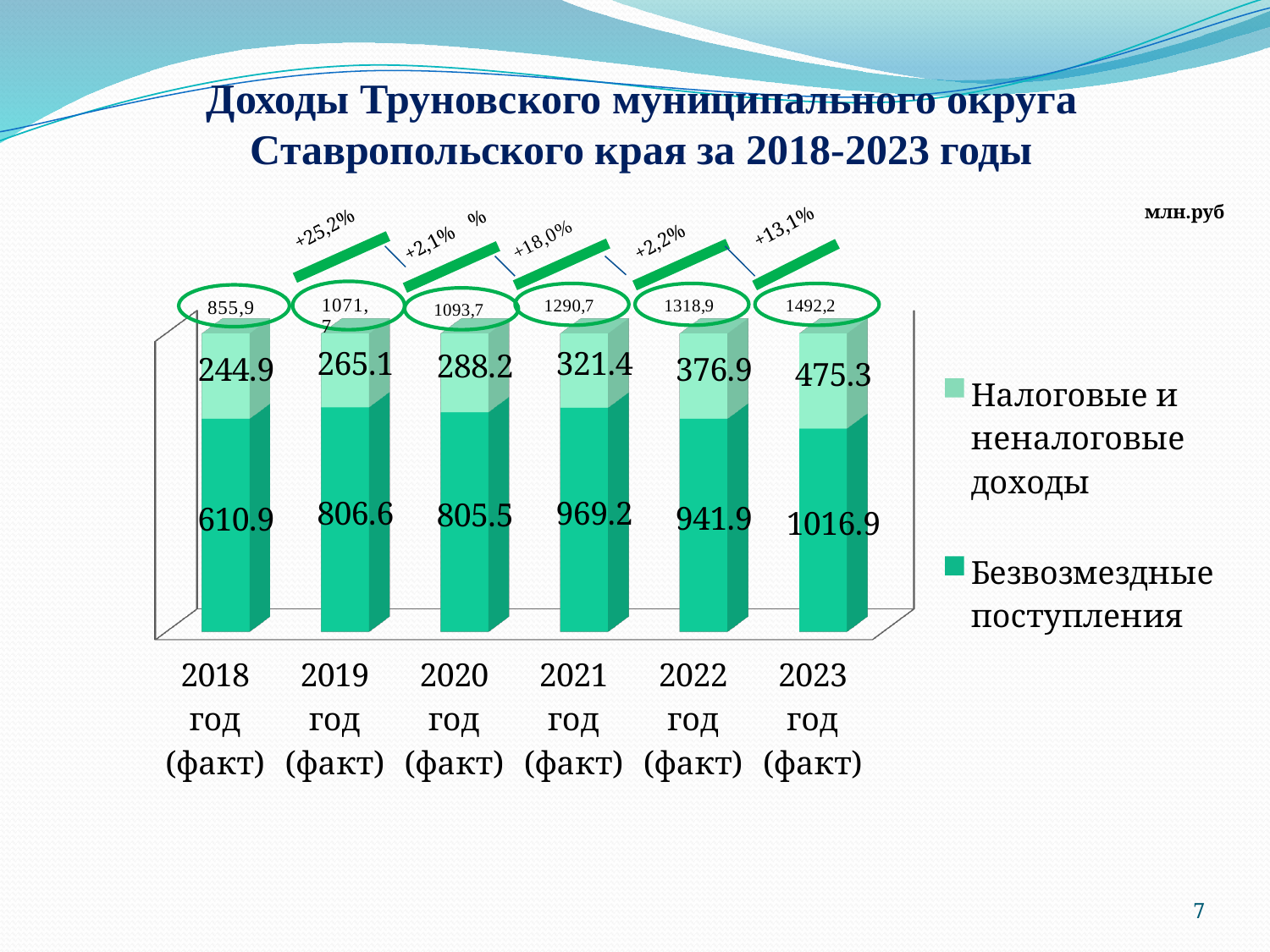
How many years are shown on the x axis of the chart? 6 By how much do Налоговые и неналоговые доходы in 2023 год (факт) exceed those in 2018 год (факт)? 230.4 What is the value of Безвозмездные поступления for 2021 год (факт)? 969.2 What is the total income shown above the bar for 2021 год (факт)? 1290,7 In which year are Безвозмездные поступления the highest? 2023 год (факт) How many series does the legend list? 2 In which year are Налоговые и неналоговые доходы the lowest? 2018 год (факт) Do Налоговые и неналоговые доходы rise or fall from 2018 to 2023? Rise What is the value of Налоговые и неналоговые доходы for 2023 год (факт)? 475.3 What growth percentage is shown between 2018 год (факт) and 2019 год (факт)? +25,2% Which year has the larger value of Безвозмездные поступления, 2021 год (факт) or 2022 год (факт)? 2021 год (факт) What kind of chart is shown on the slide? Stacked bar chart